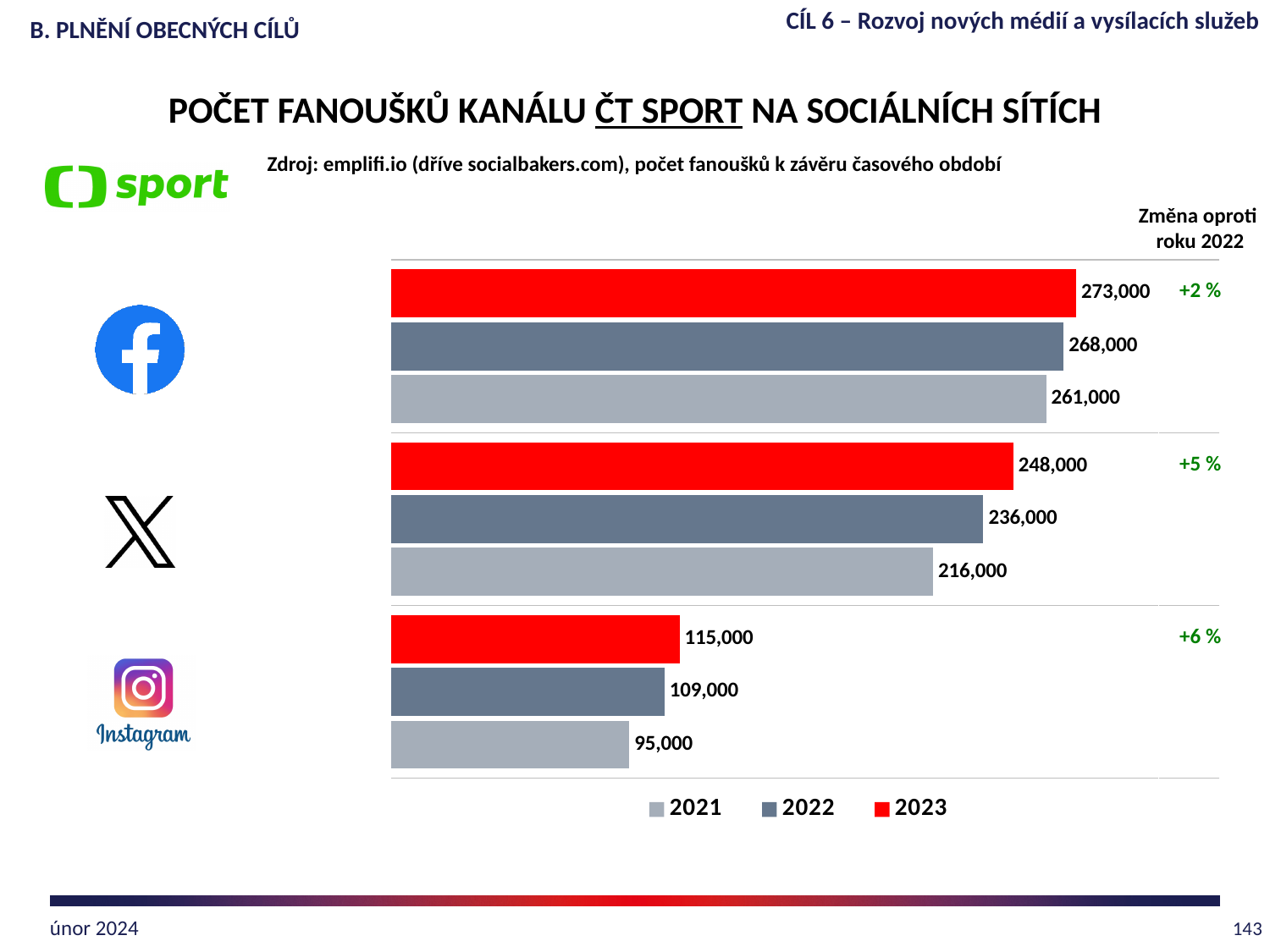
What is the percentage change in Instagram fans compared to 2022? +6 % Which social network has the highest number of ČT sport fans in 2023? Facebook By how much did the number of ČT sport fans on X increase from 2022 to 2023? 12,000 What is the number of ČT sport Facebook fans in 2023? 273,000 Which is larger: the number of Facebook fans in 2021 or the number of X fans in 2023? Facebook fans in 2021 What is the number of ČT sport fans on X in 2021? 216,000 Which colour represents the year 2023 in the chart? Red What is the number of ČT sport Instagram fans in 2022? 109,000 What kind of chart is shown on the slide? Bar chart How many series does the legend list? 3 What is the difference between Facebook fans and Instagram fans in 2023? 158,000 Which social network has the lowest number of ČT sport fans in 2021? Instagram